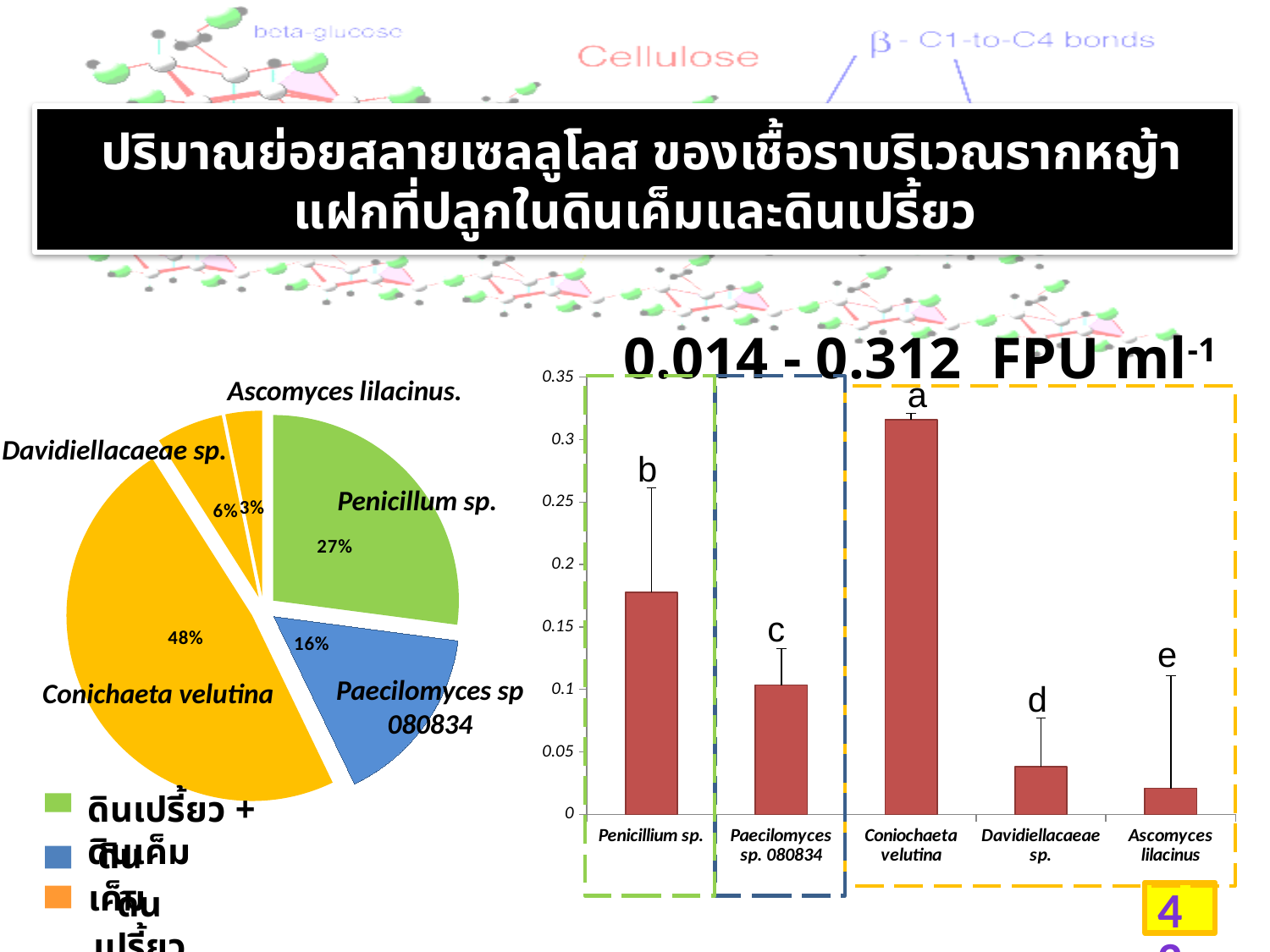
What type of chart is shown on the right side of the slide? bar chart In the pie chart on the left, what is the difference in percentage points between Conichaeta velutina and Penicillum sp.? 21 In the bar chart on the right, is the value for Penicillium sp. greater or less than 0.15? greater In the bar chart on the right, which category has the lowest bar? Ascomyces lilacinus In the pie chart on the left, which slice is the smallest? Ascomyces lilacinus In the pie chart on the left, what percentage is shown for Paecilomyces sp 080834? 16% In the pie chart on the left, which slice is the largest? Conichaeta velutina In the pie chart on the left, what percentage is shown for Conichaeta velutina? 48% In the pie chart on the left, how many slices are there? 5 In the pie chart on the left, what percentage is shown for Penicillum sp.? 27% In the bar chart on the right, is the value for Davidiellacaeae sp. greater or less than 0.05? less In the bar chart on the right, which category has the highest bar? Coniochaeta velutina